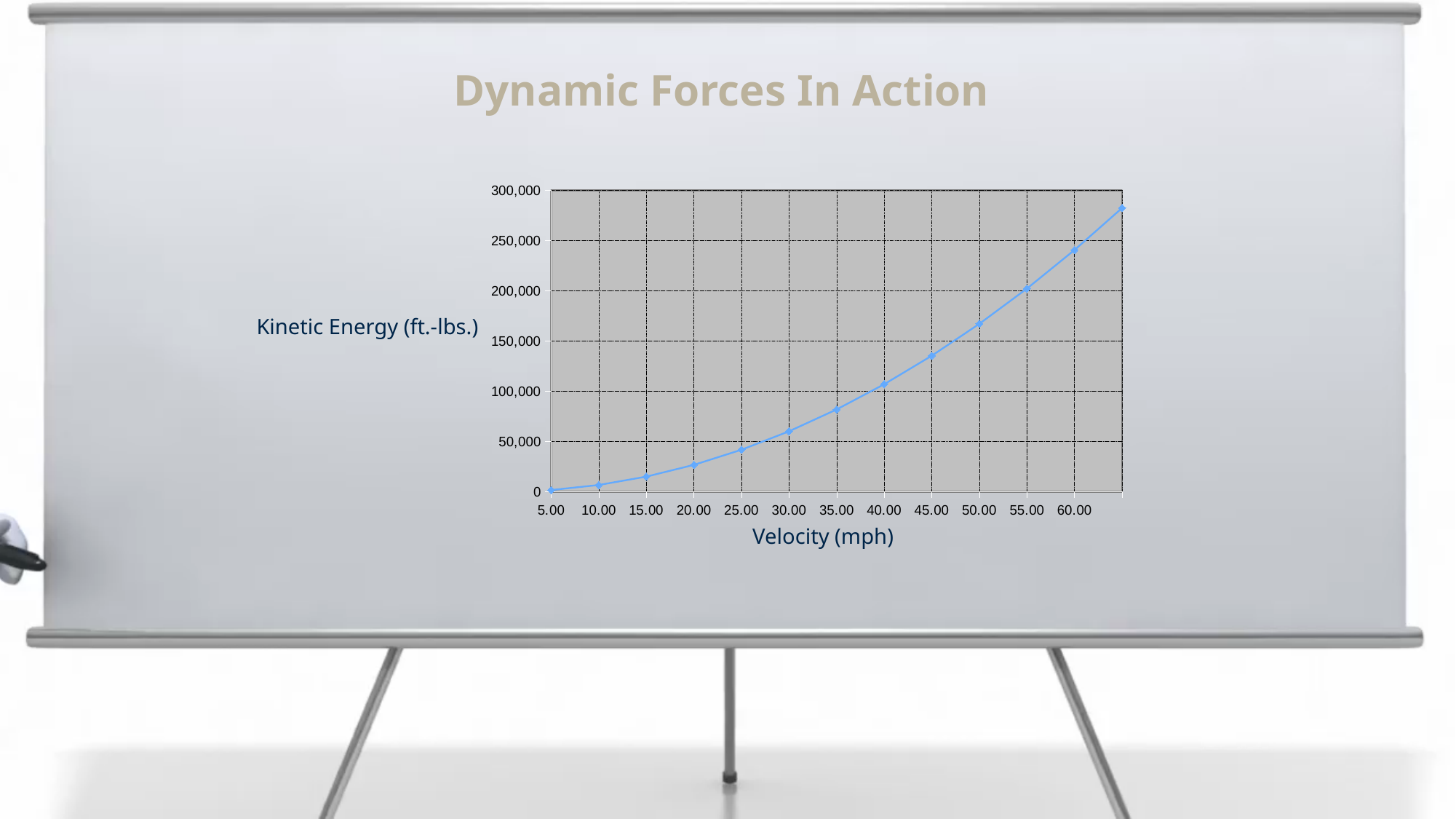
Do the kinetic energy values rise or fall as velocity increases along the x axis? rise Is the kinetic energy at 30.00 mph greater or less than 50,000? greater Is the kinetic energy at 45.00 mph greater or less than 150,000? less What is the title of the chart on the slide? Dynamic Forces In Action What is the label of the vertical axis? Kinetic Energy (ft.-lbs.) Is the kinetic energy at 20.00 mph greater or less than 50,000? less How many velocity labels are shown on the x axis? 12 At which labeled velocity is the kinetic energy lowest? 5.00 What kind of chart is shown on the slide? line chart Which has the higher kinetic energy, 20.00 mph or 40.00 mph? 40.00 mph